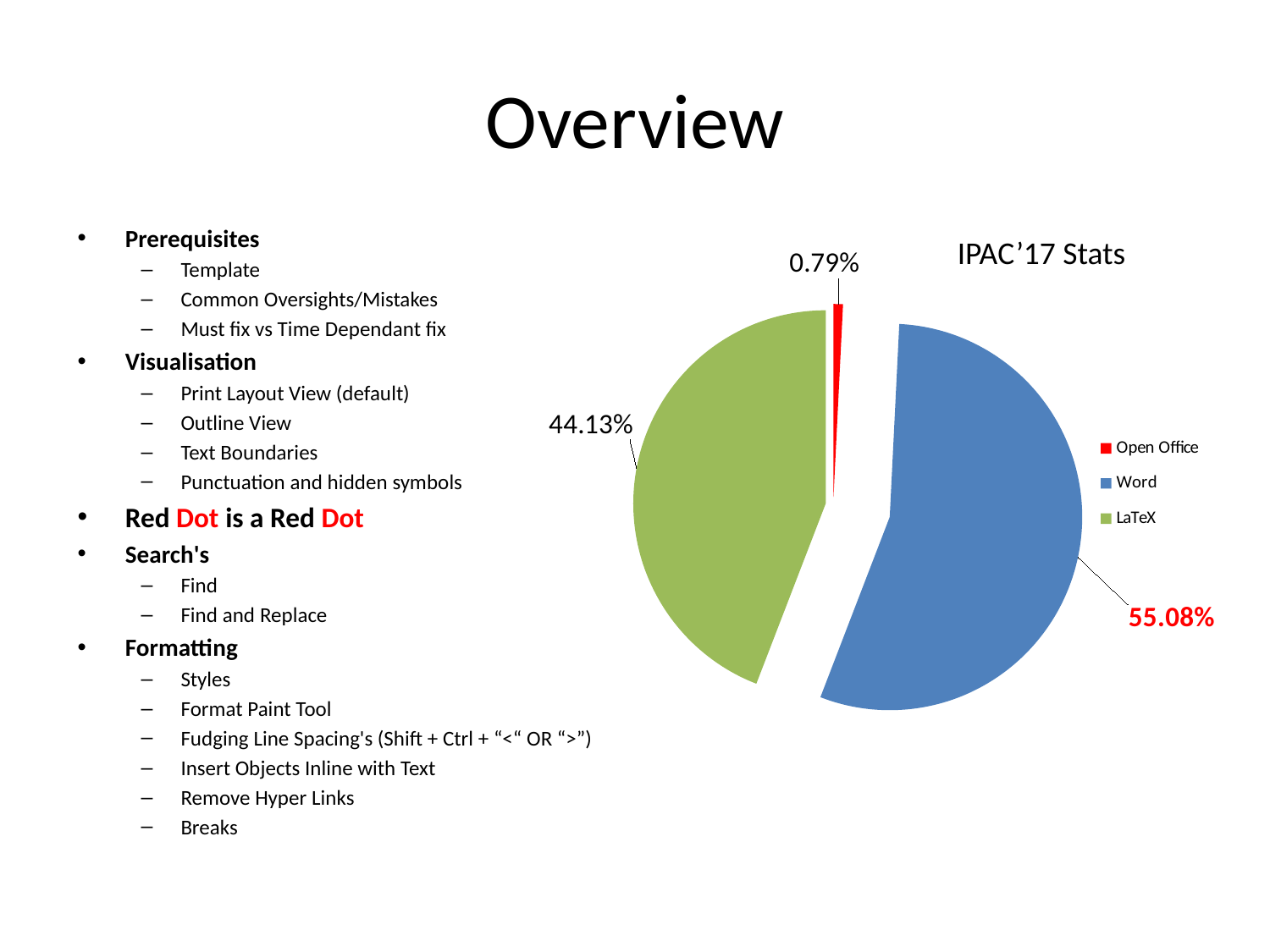
What is the difference between the Word share and the LaTeX share? 10.95% How many entries does the legend list? 3 What percentage of the pie is LaTeX? 44.13% How many slices does the pie chart have? 3 What colour is the Word slice in the pie chart? blue Which category has the smallest share of the pie? Open Office Which is larger, the share for LaTeX or the share for Open Office? LaTeX What is the title of the chart? IPAC'17 Stats Which category has the largest share of the pie? Word What kind of chart is shown on the slide? pie chart What percentage of the pie is Word? 55.08% What percentage of the pie is Open Office? 0.79%